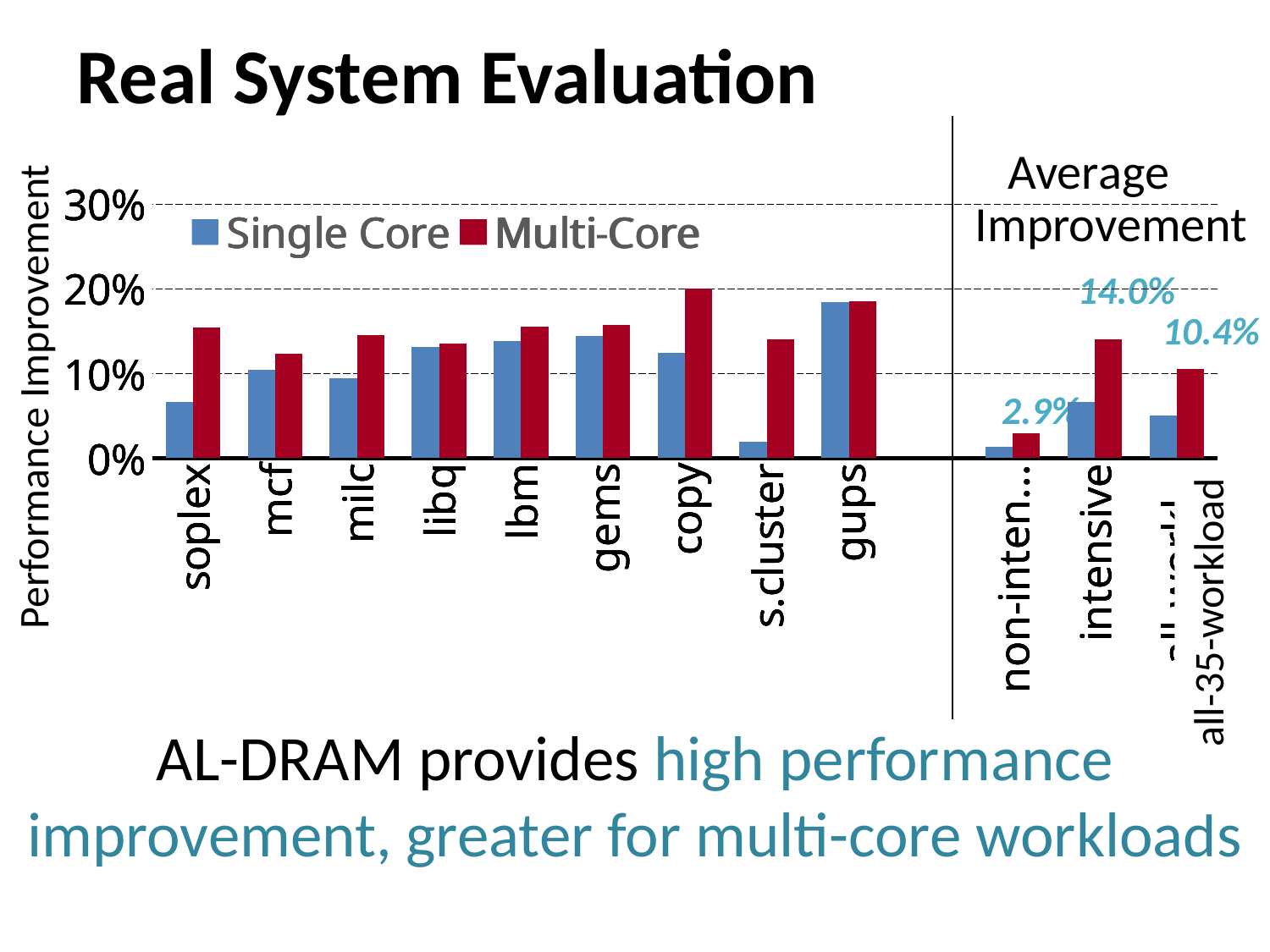
What are the two series named in the legend? Single Core and Multi-Core What is the Multi-Core average improvement for the non-intensive workloads? 2.9% Is the Single Core value for s.cluster greater or less than 10%? less What is the Multi-Core average improvement for all-35-workload? 10.4% What is the Multi-Core average improvement for the intensive workloads? 14.0% For soplex, which is larger: the Single Core value or the Multi-Core value? Multi-Core Among the nine individual workloads to the left of the vertical divider, which has the lowest Single Core value? s.cluster What is the difference between the Multi-Core average improvement for intensive workloads and for non-intensive workloads? 11.1% Is the Multi-Core value for soplex greater or less than 10%? greater What kind of chart is shown on the slide? bar chart How many series does the legend list? 2 Among the nine individual workloads to the left of the vertical divider, which has the highest Single Core value? gups